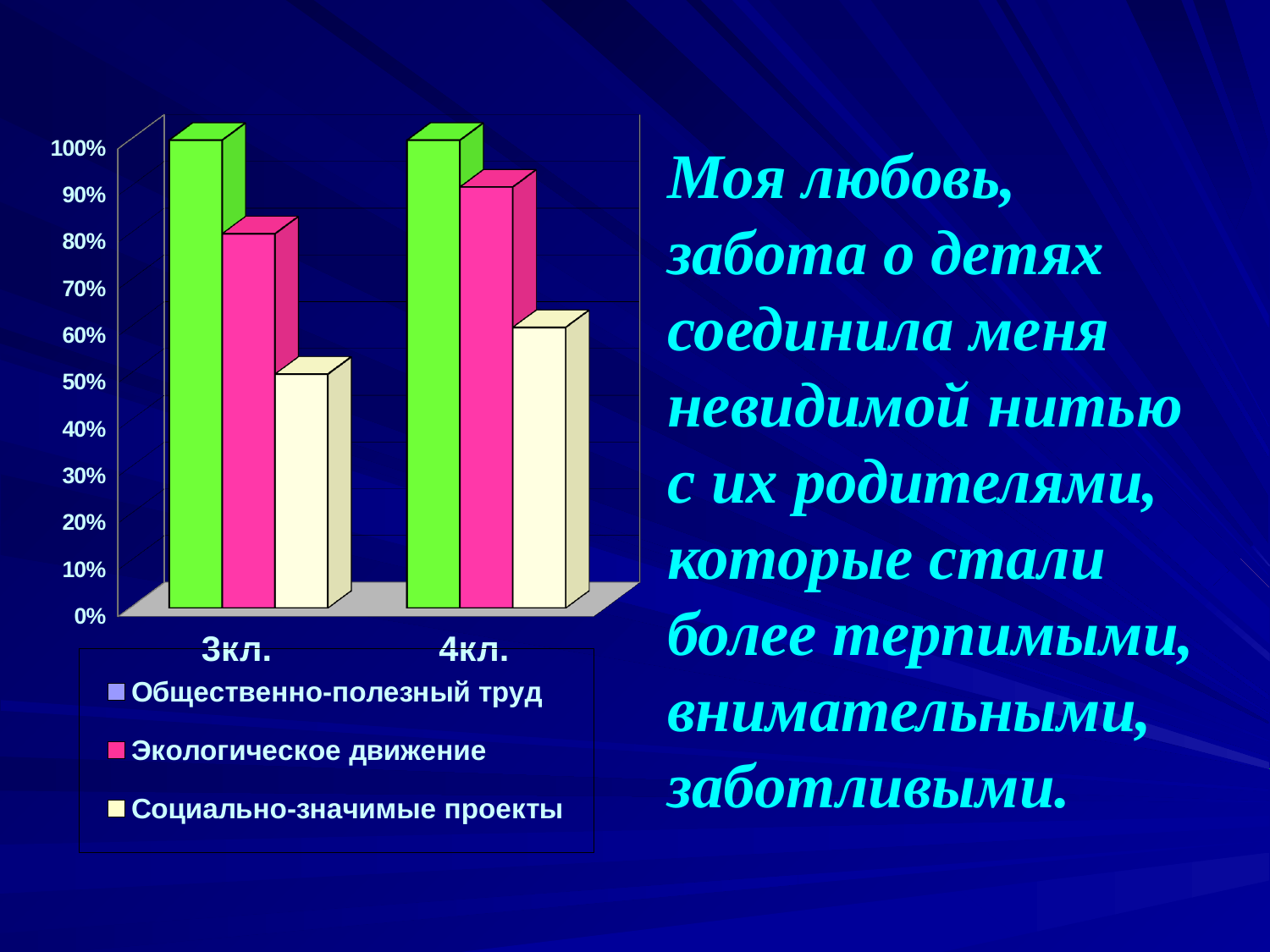
Is the value for Экологическое движение in 3кл. greater or less than 70%? greater Which series has the lowest value in 4кл.? Социально-значимые проекты What is the value for Общественно-полезный труд in 4кл.? 100% Which is larger: Экологическое движение in 3кл. or Экологическое движение in 4кл.? 4кл. Is the value for Социально-значимые проекты in 4кл. greater or less than 50%? greater Which series has the highest value in 3кл.? Общественно-полезный труд What kind of chart is shown on the slide? bar chart How many series does the chart legend list? 3 How many categories are shown on the x axis of the chart? 2 Do the values for Социально-значимые проекты rise or fall from 3кл. to 4кл.? rise Is the value for Социально-значимые проекты in 3кл. greater or less than 60%? less What is the value for Общественно-полезный труд in 3кл.? 100%